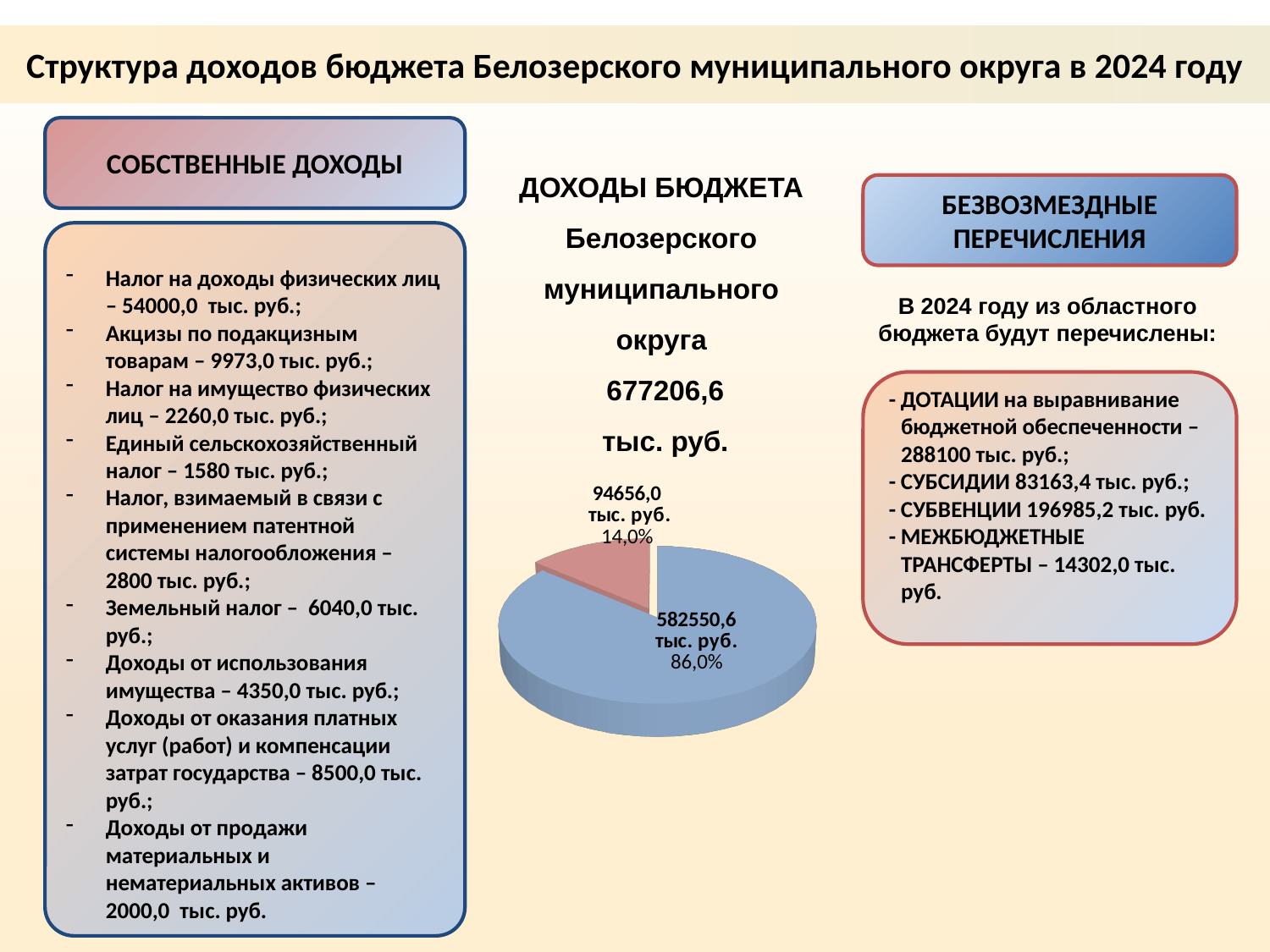
How many slices does the pie chart have? 2 Which is larger: the blue slice or the pink slice? The blue slice Which slice of the pie chart is the smallest? The pink slice (94656,0 тыс. руб.) What is the total of the two slices in the pie chart, as stated on the slide? 677206,6 тыс. руб. What colour is the slice labelled 14,0%? Pink What value is printed on the larger (blue) slice of the pie chart? 582550,6 тыс. руб. Which slice of the pie chart is the largest? The blue slice (582550,6 тыс. руб.) What value is printed on the smaller (pink) slice of the pie chart? 94656,0 тыс. руб. What is the difference between the two slice values in the pie chart? 487894,6 тыс. руб. What share of the pie does the blue slice represent? 86,0% What share of the pie does the pink slice represent? 14,0% What kind of chart is shown on the slide? Pie chart